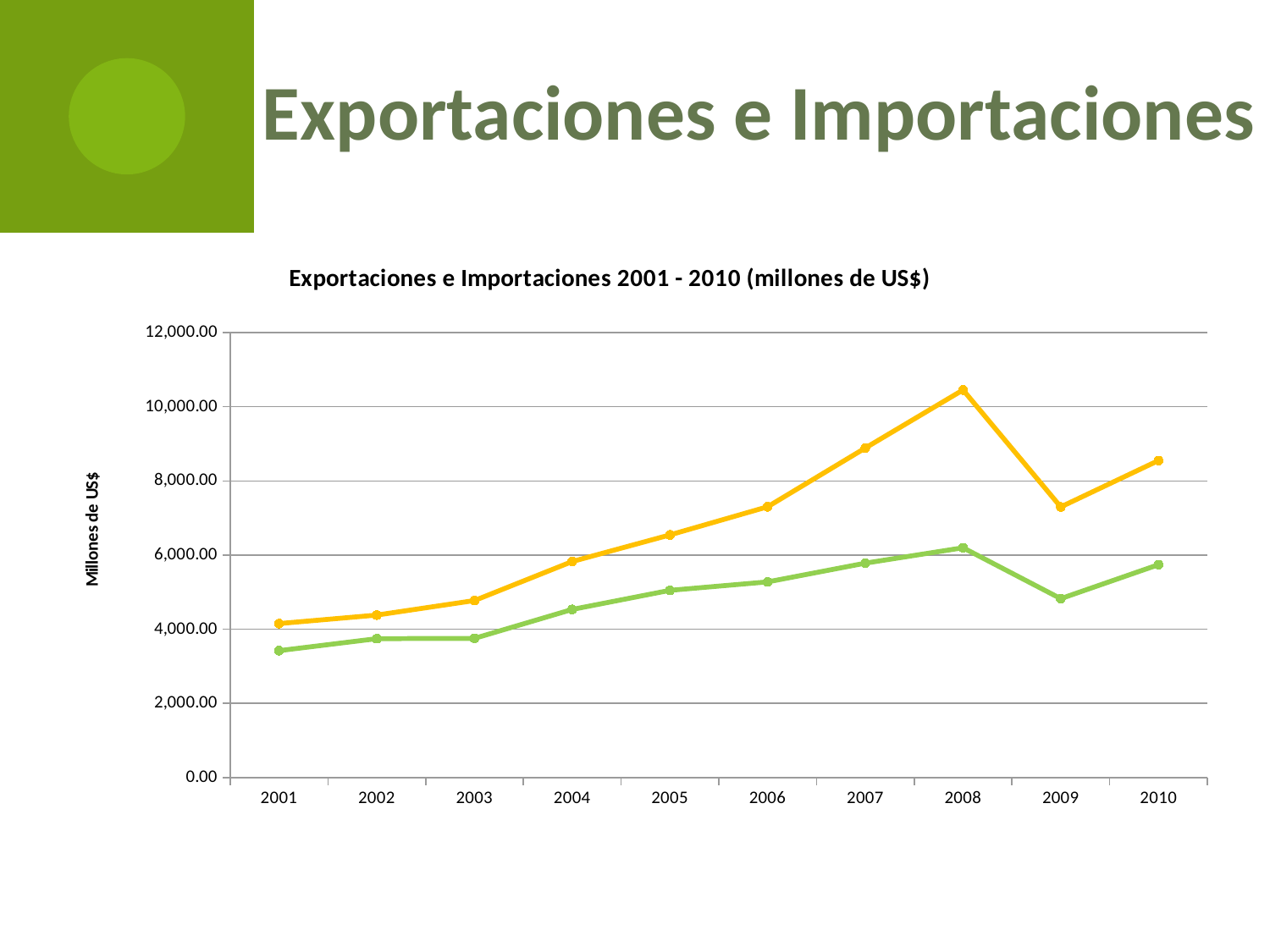
Is the value of the orange line in 2008 greater or less than 10,000.00? greater For the orange line, which year has the larger value, 2009 or 2010? 2010 What is the title of the chart? Exportaciones e Importaciones 2001 - 2010 (millones de US$) In which year does the orange line have its lowest value? 2001 Does the orange line rise or fall from 2001 to 2008? rises How many years are plotted along the x axis of the chart? 10 What kind of chart is shown on the slide? line chart In which year does the orange line reach its highest value? 2008 In which year does the green line have its lowest value? 2001 In which year does the green line reach its highest value? 2008 Is the value of the green line in 2001 greater or less than 4,000.00? less Is the value of the orange line in 2007 greater or less than 8,000.00? greater